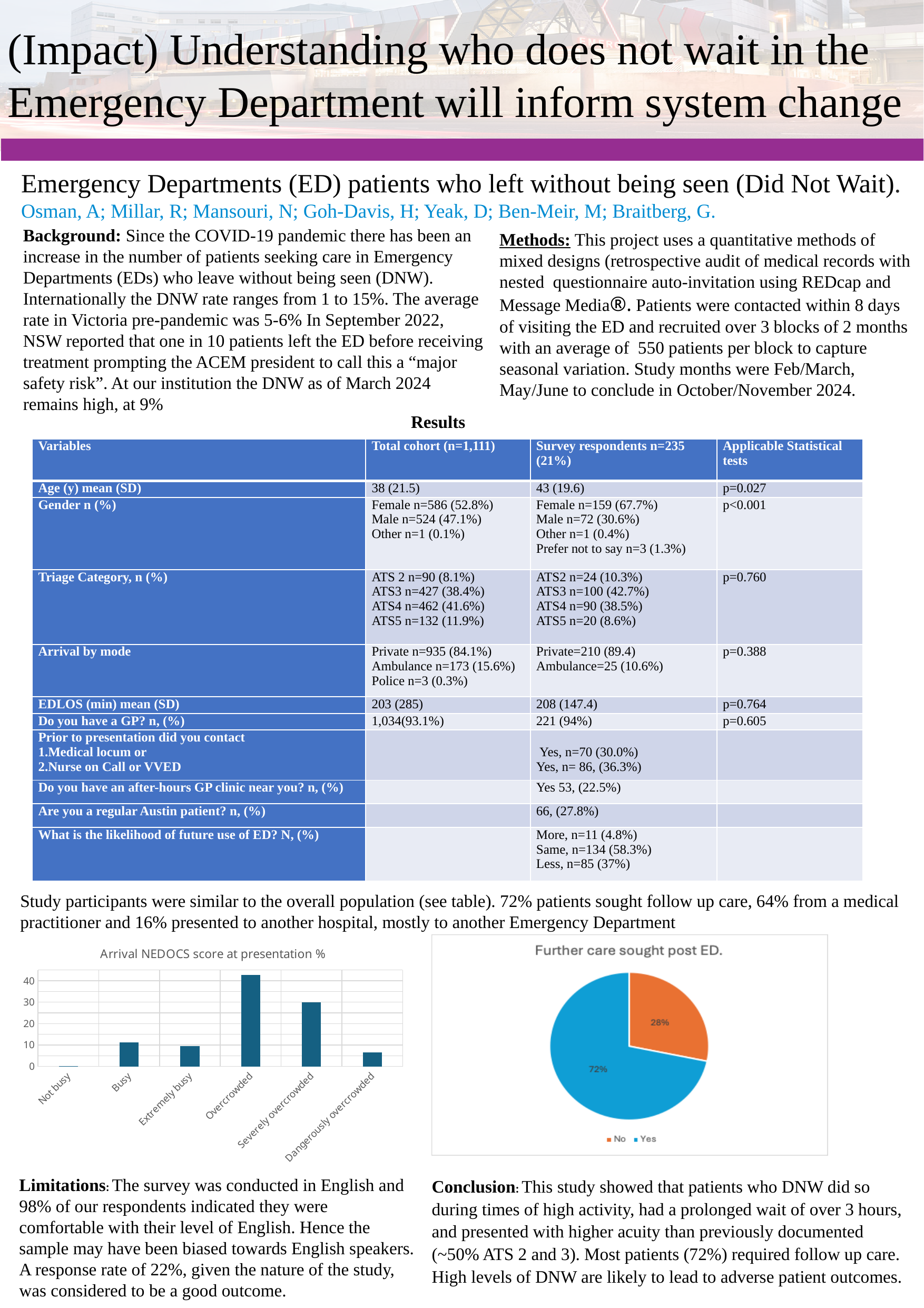
In the 'Arrival NEDOCS score at presentation %' chart, what kind of chart is shown? bar chart In the 'Arrival NEDOCS score at presentation %' chart, is the value for Dangerously overcrowded greater or less than 10? less In the 'Arrival NEDOCS score at presentation %' chart, which category has the lowest value? Not busy In the 'Arrival NEDOCS score at presentation %' chart, is the value for Overcrowded greater or less than 40? greater In the 'Further care sought post ED.' chart, what colour is the 'Yes' slice? blue In the 'Further care sought post ED.' chart, what share of the pie is 'No'? 28% In the 'Further care sought post ED.' chart, what is the difference between the 'Yes' and 'No' shares? 44% In the 'Arrival NEDOCS score at presentation %' chart, is the value for Busy greater or less than 20? less In the 'Arrival NEDOCS score at presentation %' chart, which category has the highest value? Overcrowded In the 'Further care sought post ED.' chart, what share of the pie is 'Yes'? 72% In the 'Arrival NEDOCS score at presentation %' chart, which is larger, the value for Busy or the value for Severely overcrowded? Severely overcrowded In the 'Arrival NEDOCS score at presentation %' chart, how many categories are shown on the x axis? 6